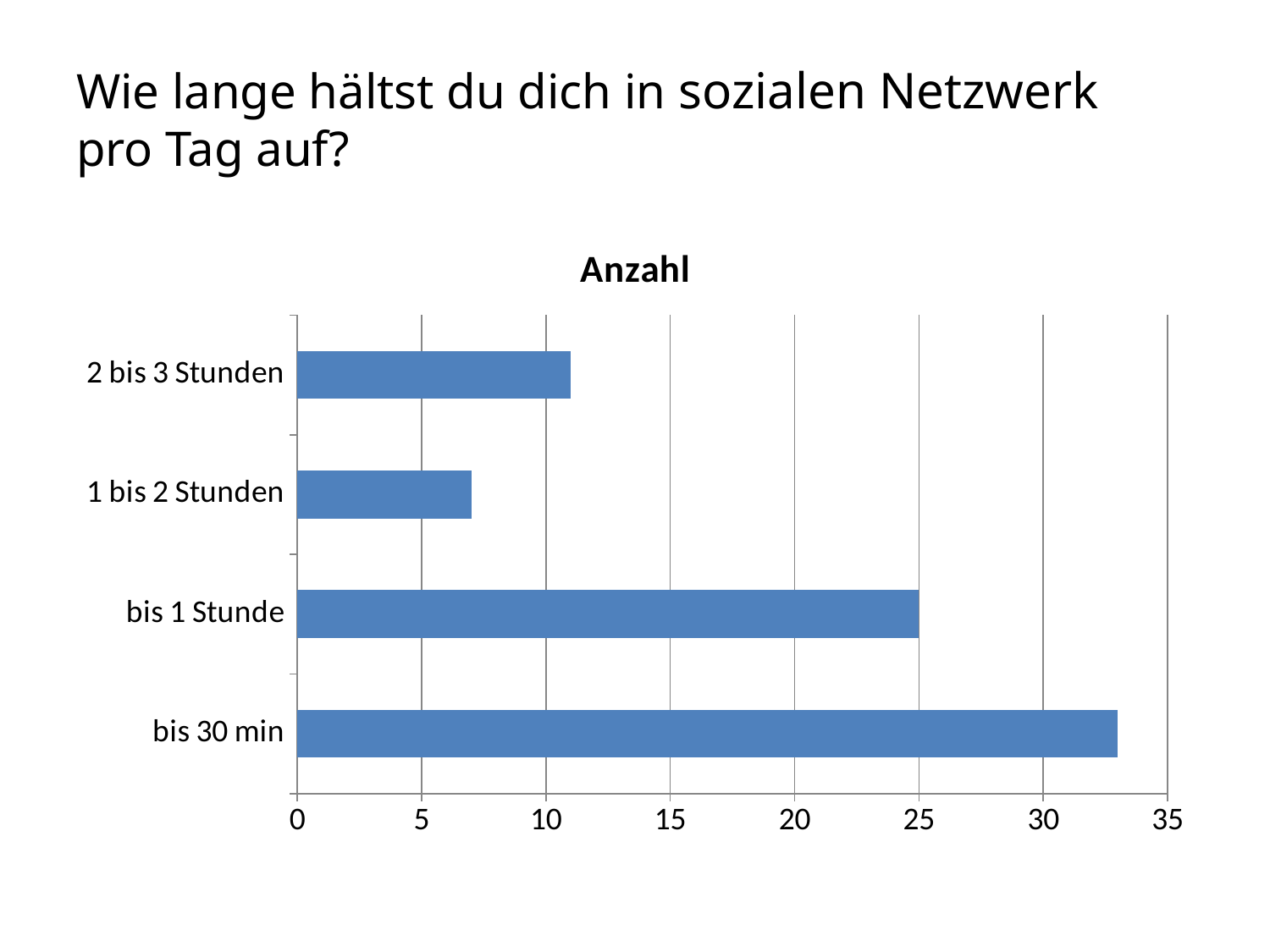
Is the value for 2 bis 3 Stunden greater or less than 10? greater Which is larger, the value for 2 bis 3 Stunden or the value for 1 bis 2 Stunden? 2 bis 3 Stunden How many categories are shown in the chart? 4 Which category has the highest value? bis 30 min Which category has the lowest value? 1 bis 2 Stunden Is the value for bis 30 min greater or less than 30? greater Is the value for 2 bis 3 Stunden greater or less than 15? less What is the value for bis 1 Stunde? 25 What is the title of the chart? Anzahl Which is larger, the value for bis 1 Stunde or the value for 2 bis 3 Stunden? bis 1 Stunde What kind of chart is shown on the slide? bar chart